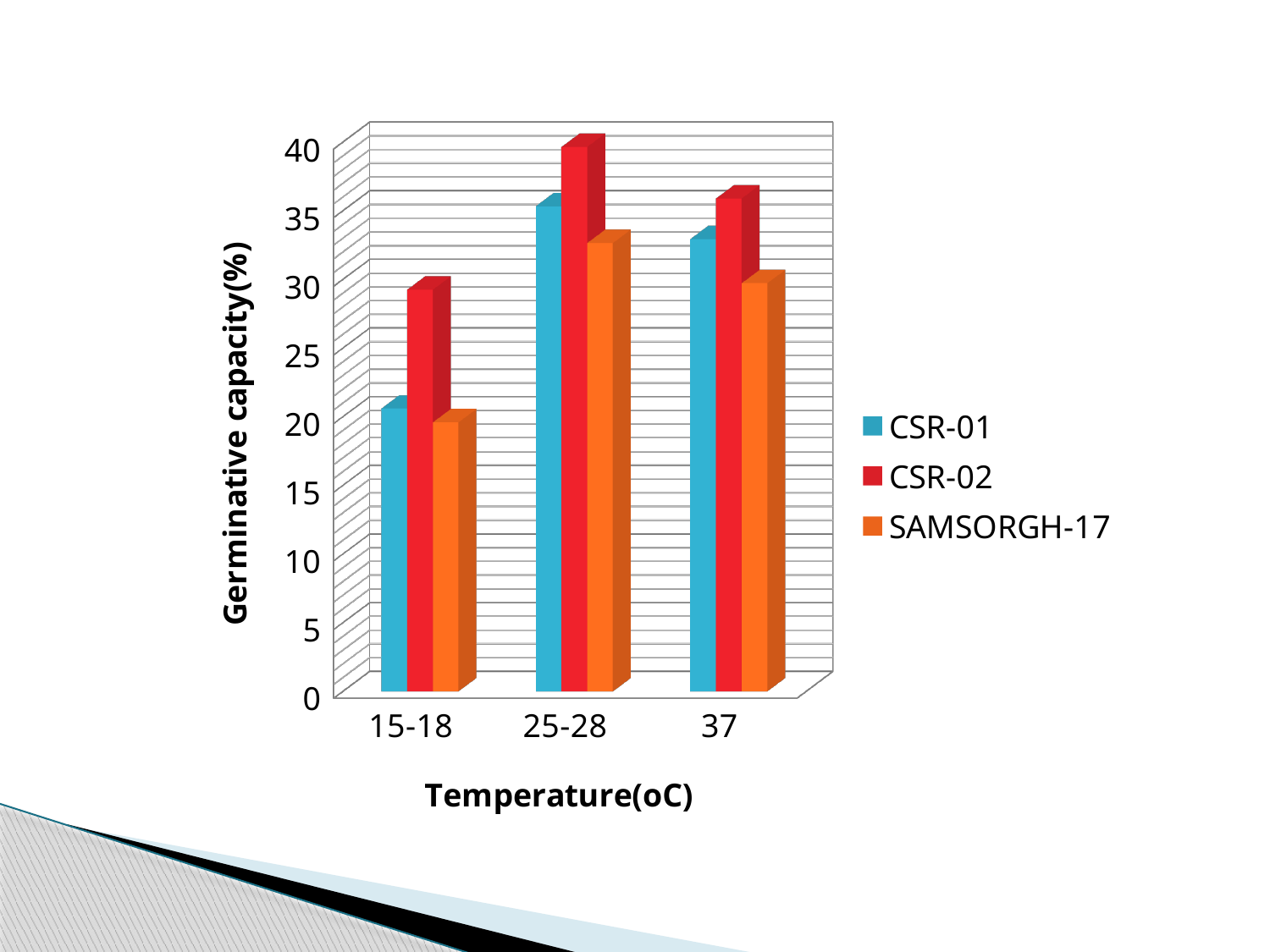
Is the germinative capacity of CSR-02 at 15-18 greater or less than 25? greater At which temperature does CSR-02 reach its highest germinative capacity? 25-28 What kind of chart is shown on the slide? bar chart What is the label of the vertical axis? Germinative capacity(%) How many temperature categories are shown on the x axis? 3 How many series does the legend list? 3 At which temperature is the germinative capacity of CSR-01 lowest? 15-18 Is the germinative capacity of CSR-02 at 25-28 greater or less than 35? greater At 15-18, which has the higher germinative capacity, CSR-01 or CSR-02? CSR-02 Is the germinative capacity of SAMSORGH-17 at 15-18 greater or less than 25? less Which series has the highest germinative capacity at 37? CSR-02 At 25-28, which has the higher germinative capacity, CSR-01 or SAMSORGH-17? CSR-01